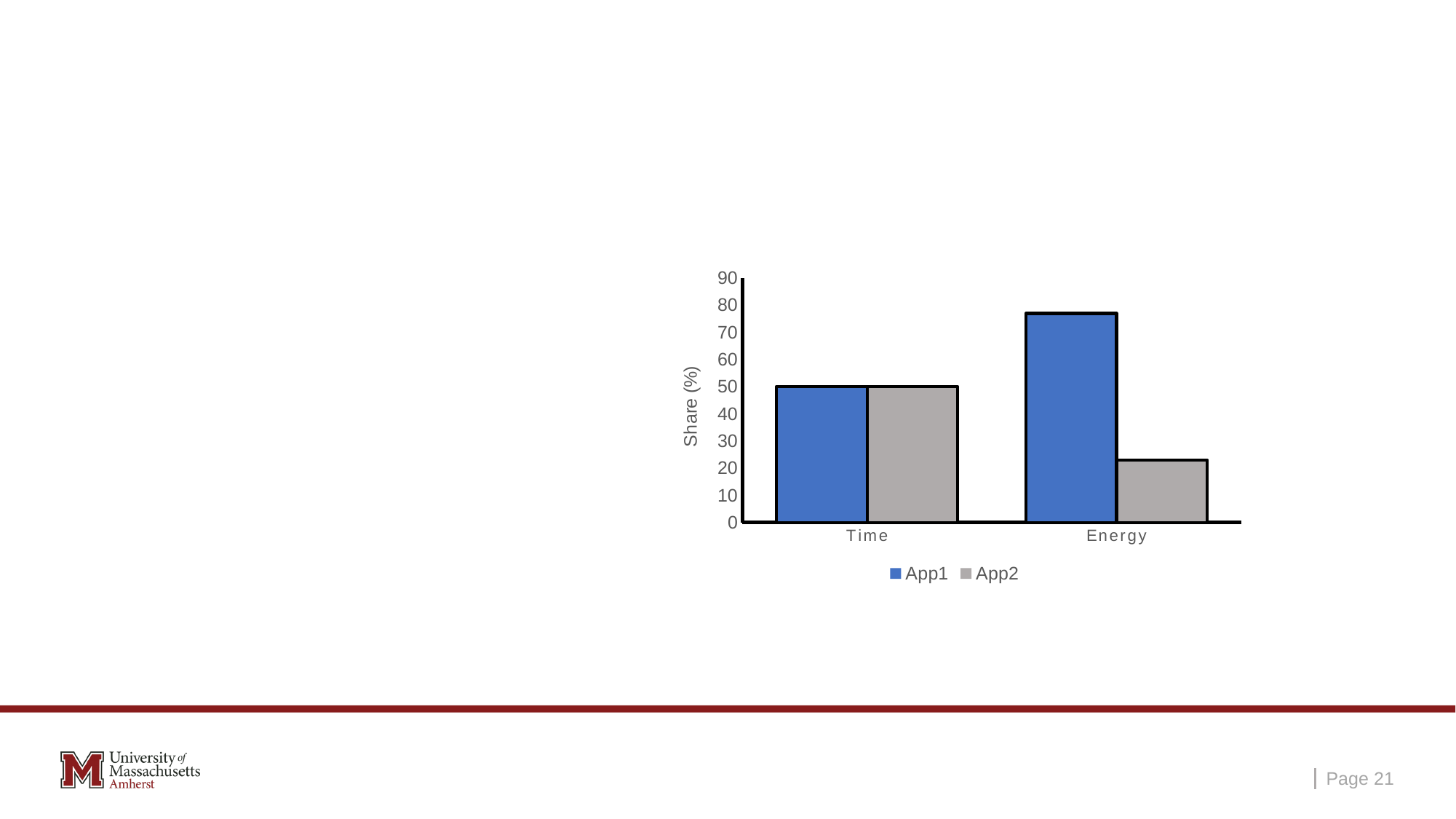
How many categories are shown on the x axis of the chart? 2 Is the value for App1 in the Energy category greater or less than 70? greater What is the value for App1 in the Time category? 50 Is the value for App2 in the Energy category greater or less than 30? less What colour are the App2 bars in the chart? grey What kind of chart is shown on the slide? bar chart What is the value for App2 in the Time category? 50 What is the label of the y axis of the chart? Share (%) In the Energy category, which series has the larger value, App1 or App2? App1 Which category has the highest App1 value? Energy Which category has the lowest App2 value? Energy How many series does the chart's legend list? 2